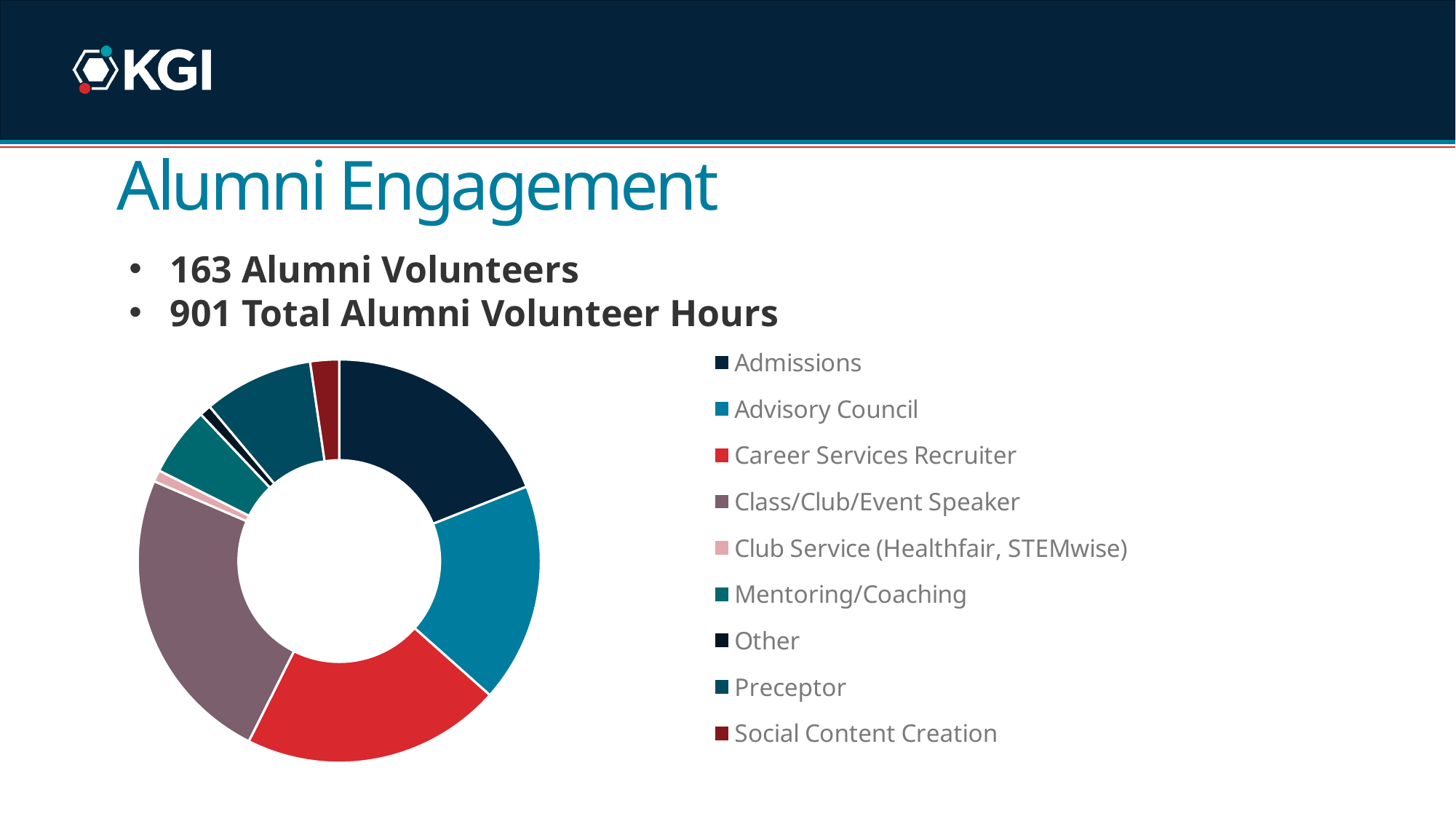
Which slice is larger in the donut chart: Advisory Council or Preceptor? Advisory Council How many categories does the legend of the donut chart list? 9 Which slice is larger in the donut chart: Admissions or Social Content Creation? Admissions What kind of chart is shown on the slide? Donut (pie) chart How many slices does the donut chart have? 9 Which slice is larger in the donut chart: Class/Club/Event Speaker or Club Service (Healthfair, STEMwise)? Class/Club/Event Speaker Which legend entry of the donut chart is listed last? Social Content Creation What colour represents Career Services Recruiter in the donut chart legend? Red